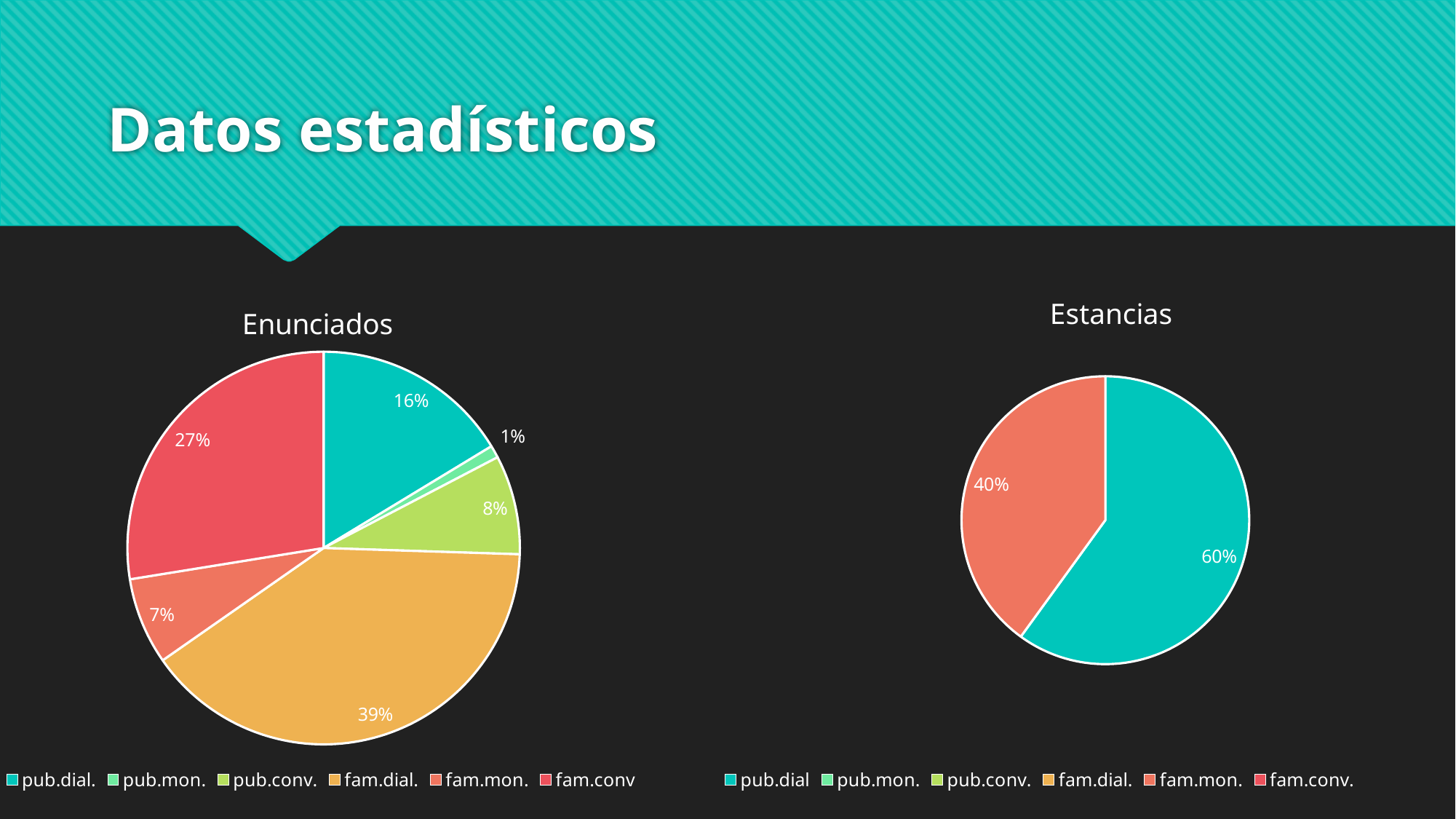
In the Enunciados chart, what share does fam.dial. have? 39% In the Estancias chart, what is the difference between the two slices shown? 20% In the Enunciados chart, what share does pub.dial. have? 16% In the Estancias chart, what share does pub.dial have? 60% In the Enunciados chart, which category has the largest slice? fam.dial. In the Enunciados chart, which is larger, pub.conv. or fam.mon.? pub.conv. How many entries does the legend of the Enunciados chart list? 6 What type of chart is the Enunciados chart? Pie chart In the Enunciados chart, which category has the smallest slice? pub.mon. In the Enunciados chart, what is the difference between the fam.dial. and fam.conv shares? 12% In the Enunciados chart, what share does fam.conv have? 27% How many slices are visible in the Estancias chart? 2